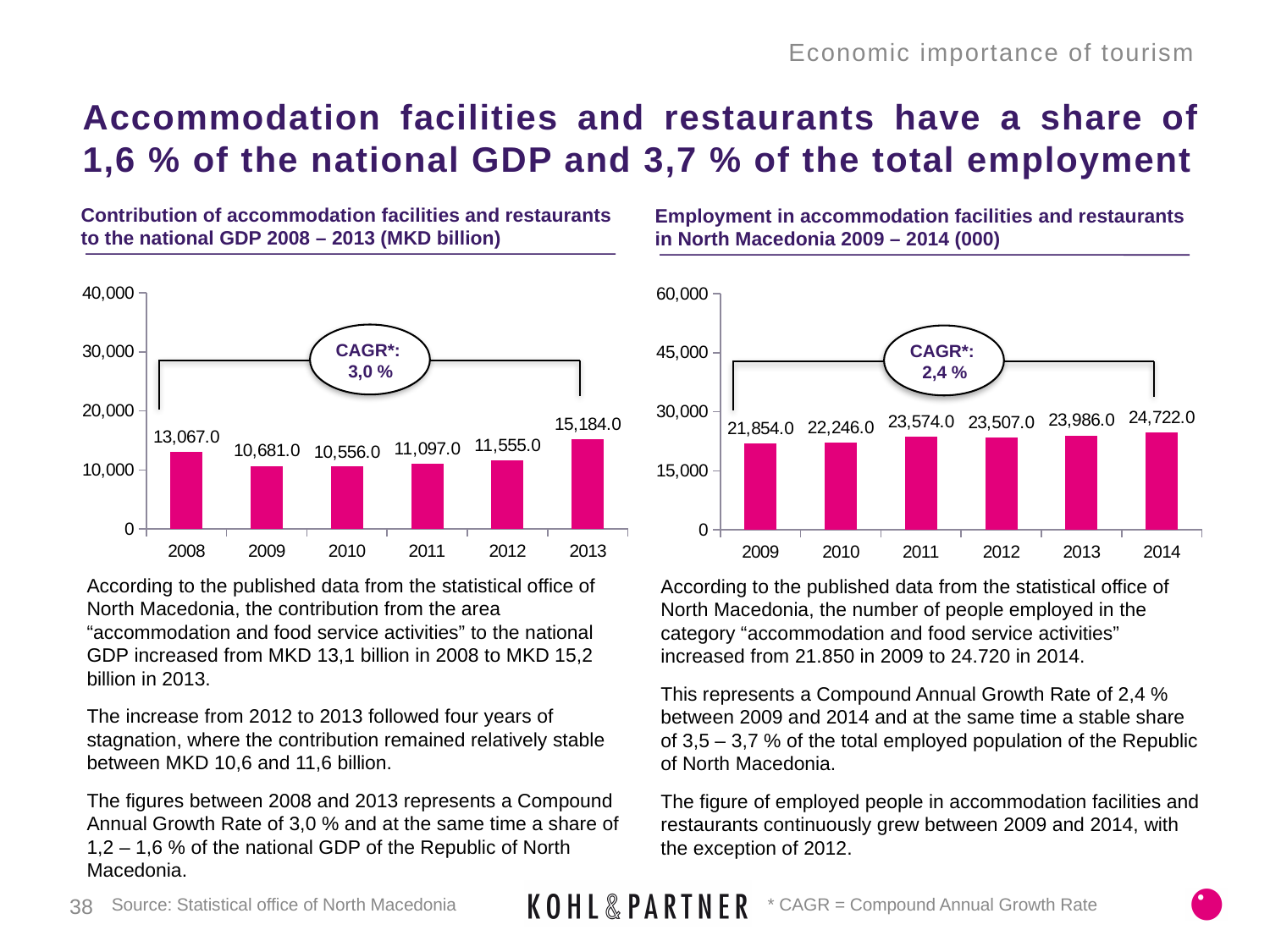
In the left chart (Contribution to the national GDP), which year has the highest value? 2013 In the right chart (Employment in accommodation facilities and restaurants), what is the difference between the 2014 value and the 2009 value? 2,868.0 What type of chart is used in the left chart (Contribution to the national GDP)? Bar chart In the right chart (Employment in accommodation facilities and restaurants), what is the value for 2011? 23,574.0 In the left chart (Contribution to the national GDP), how many years are shown on the x axis? 6 In the right chart (Employment in accommodation facilities and restaurants), which year has the lowest value? 2009 In the left chart (Contribution of accommodation facilities and restaurants to the national GDP), what is the value for 2008? 13,067.0 In the right chart (Employment in accommodation facilities and restaurants), is the value for 2012 larger or smaller than the value for 2011? smaller In the left chart (Contribution to the national GDP), what is the difference between the 2013 value and the 2012 value? 3,629.0 In the left chart (Contribution to the national GDP), which year has the lowest value? 2010 In the right chart (Employment in accommodation facilities and restaurants), what is the value for 2014? 24,722.0 In the left chart (Contribution to the national GDP), what is the value for 2013? 15,184.0